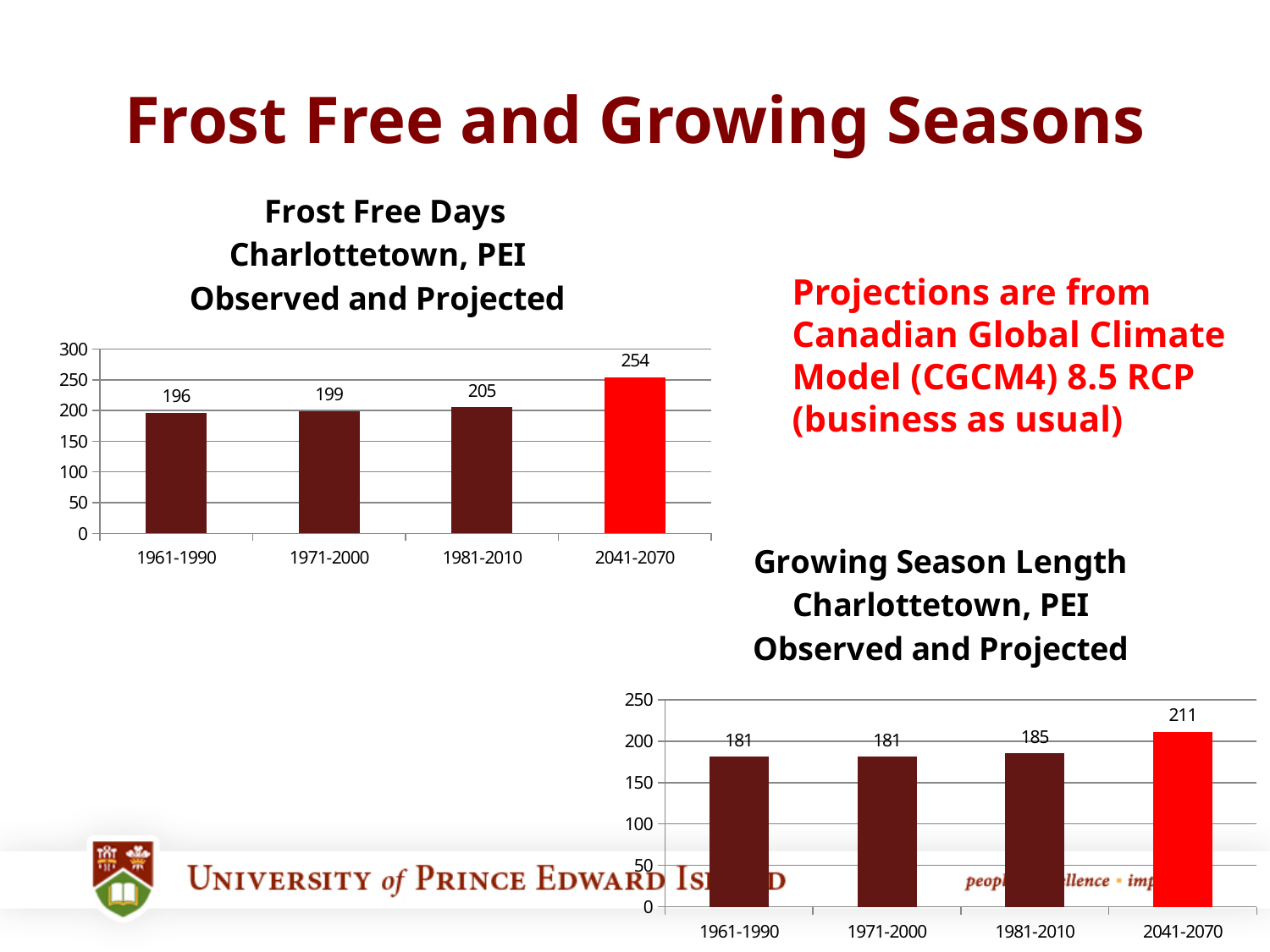
In the Growing Season Length chart, do the values rise or fall from 1961-1990 to 2041-2070? Rise In the Frost Free Days chart, what is the value for 2041-2070? 254 In the Frost Free Days chart, which period has the highest value? 2041-2070 In the Frost Free Days chart, what is the difference between the values for 2041-2070 and 1981-2010? 49 In the Growing Season Length chart, which bar is coloured red? 2041-2070 In the Frost Free Days chart, which period has the lowest value? 1961-1990 In the Frost Free Days chart, how many periods are shown on the x axis? 4 In the Frost Free Days chart, what is the value for 1961-1990? 196 What kind of chart is the Frost Free Days chart? Bar chart In the Growing Season Length chart, what is the value for 1981-2010? 185 In the Growing Season Length chart, what is the value for 2041-2070? 211 In the Growing Season Length chart, what is the difference between the values for 2041-2070 and 1961-1990? 30